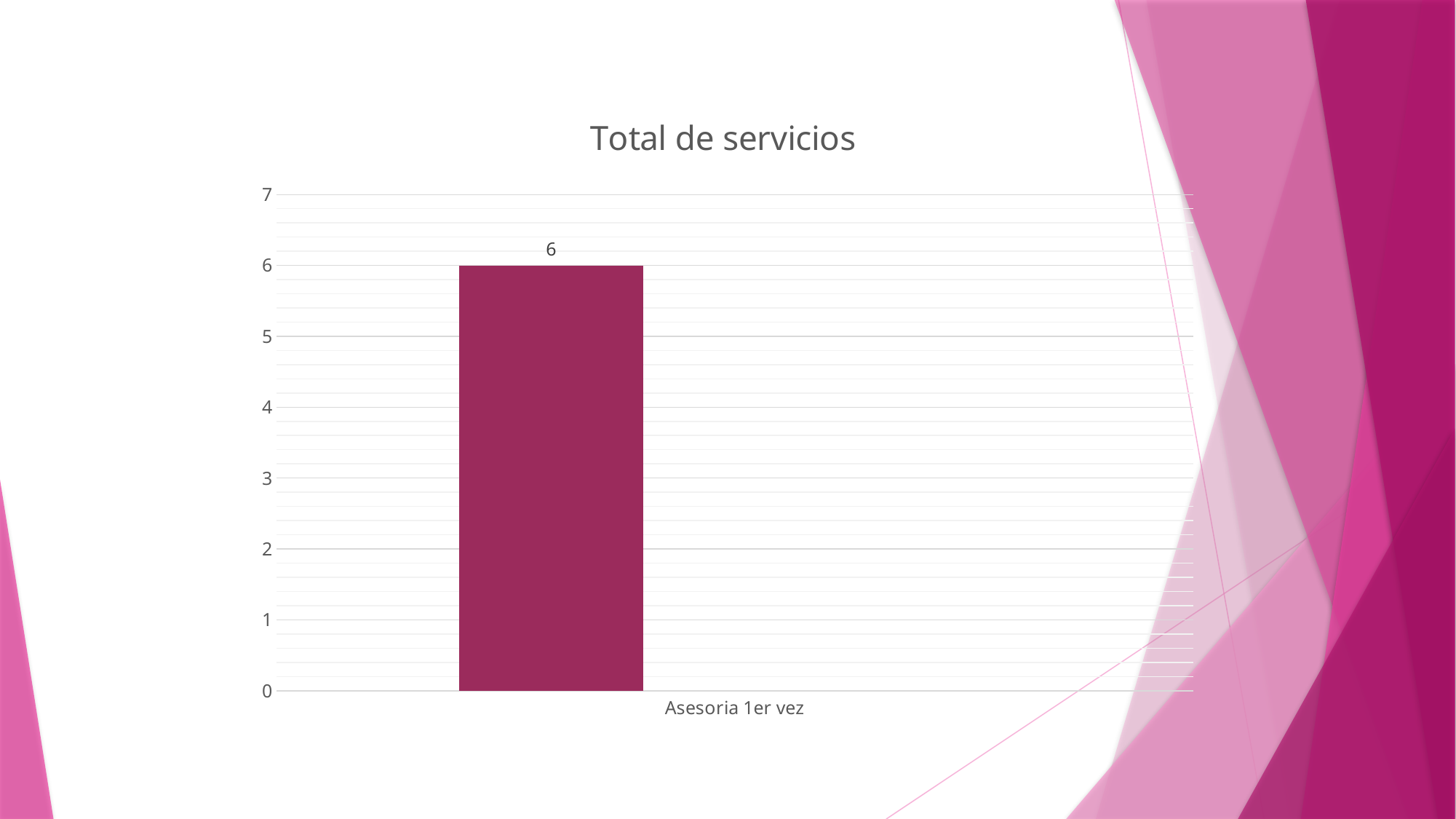
What is the title of the chart? Total de servicios What is the value for Asesoria 1er vez? 6 Is the value for Asesoria 1er vez greater or less than 5? greater What kind of chart is shown on the slide? bar chart What is the highest value shown on the vertical axis? 7 Is the value for Asesoria 1er vez greater or less than 7? less What is the label of the only category on the x axis? Asesoria 1er vez How many categories are plotted in the chart? 1